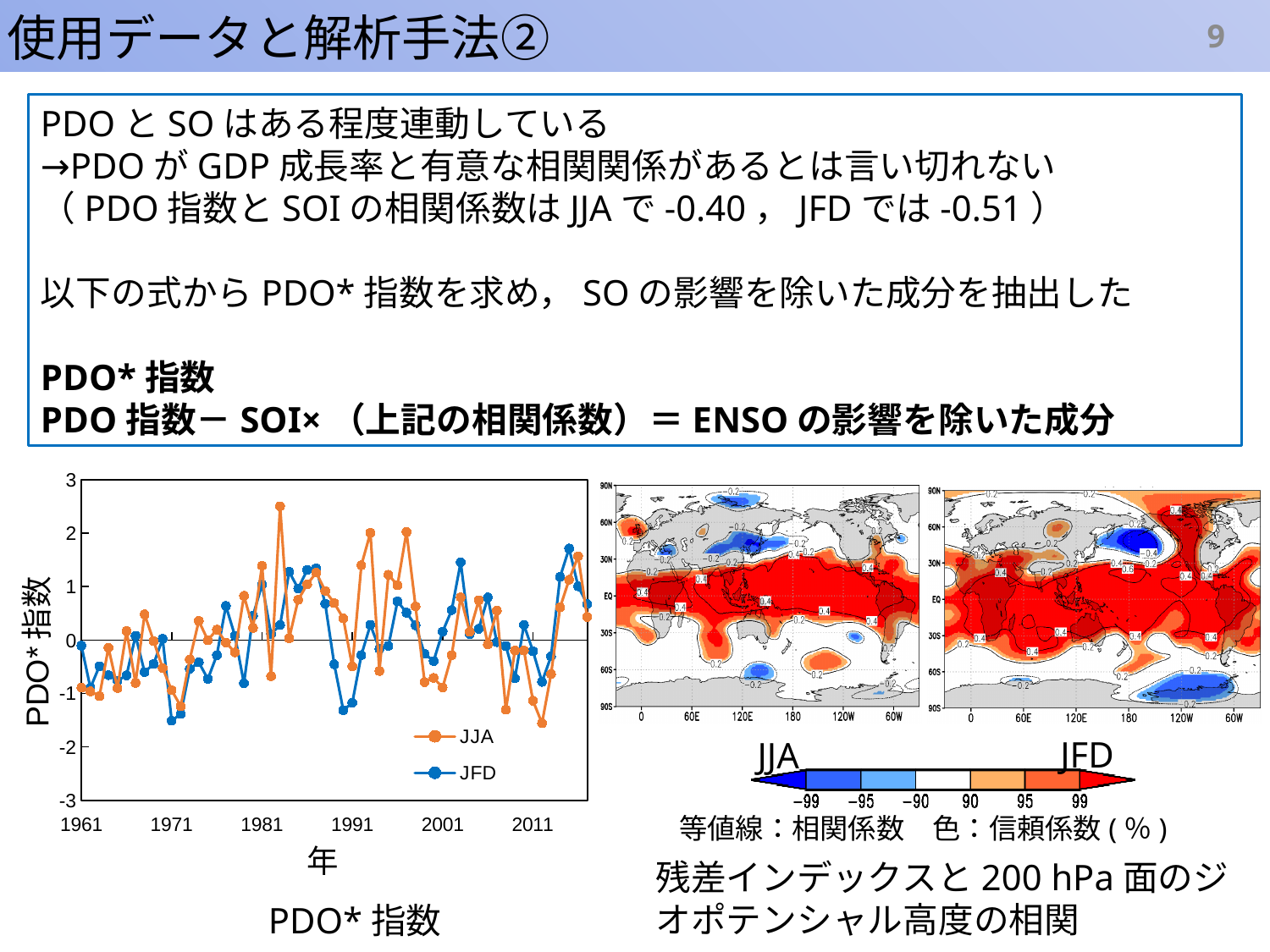
How many series does the legend of the 'PDO* 指数' line chart list? 2 In the 'PDO* 指数' line chart, is the JFD value around 1972 greater or less than -1? less In the 'PDO* 指数' line chart, what are the two series named in the legend? JJA and JFD In the 'PDO* 指数' line chart, is the JJA value around 2012 greater or less than -1? less In the 'PDO* 指数' line chart, what is the first year shown on the x axis? 1961 In the 'PDO* 指数' line chart, is the JJA value in 1961 greater or less than 0? less What kind of chart is the 'PDO* 指数' chart on the left of the slide? line chart In the 'PDO* 指数' line chart, what is the label on the x axis? 年 In the 'PDO* 指数' line chart, which series reaches the highest value over the whole period? JJA In the 'PDO* 指数' line chart, what is the maximum value shown on the y axis? 3